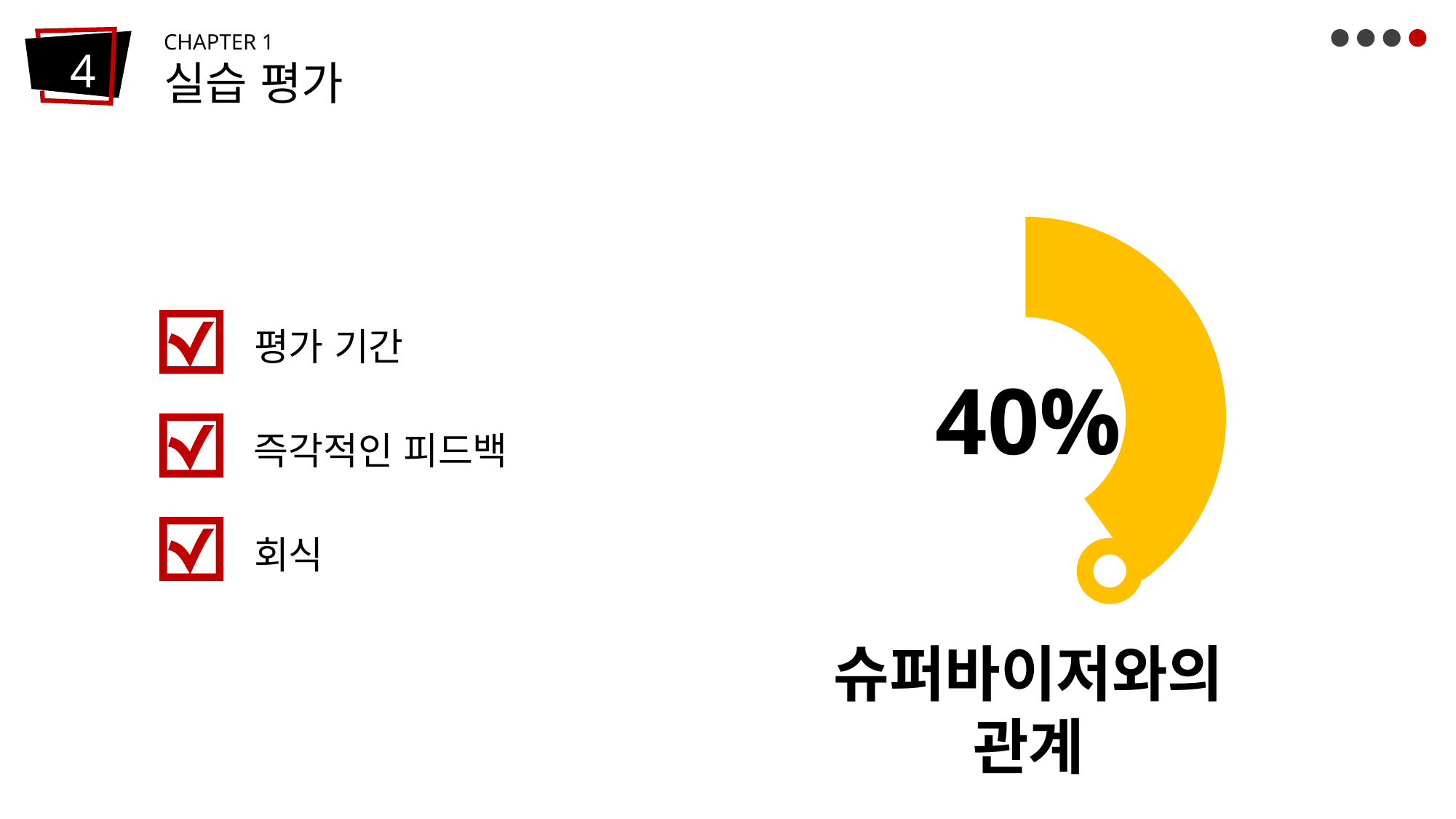
Is the value shown for 슈퍼바이저와의 관계 greater or less than 50%? less What label appears below the yellow arc graphic showing 40%? 슈퍼바이저와의 관계 What percentage is shown next to the yellow arc graphic for 슈퍼바이저와의 관계? 40% What colour is the arc graphic next to the 40% figure? Yellow